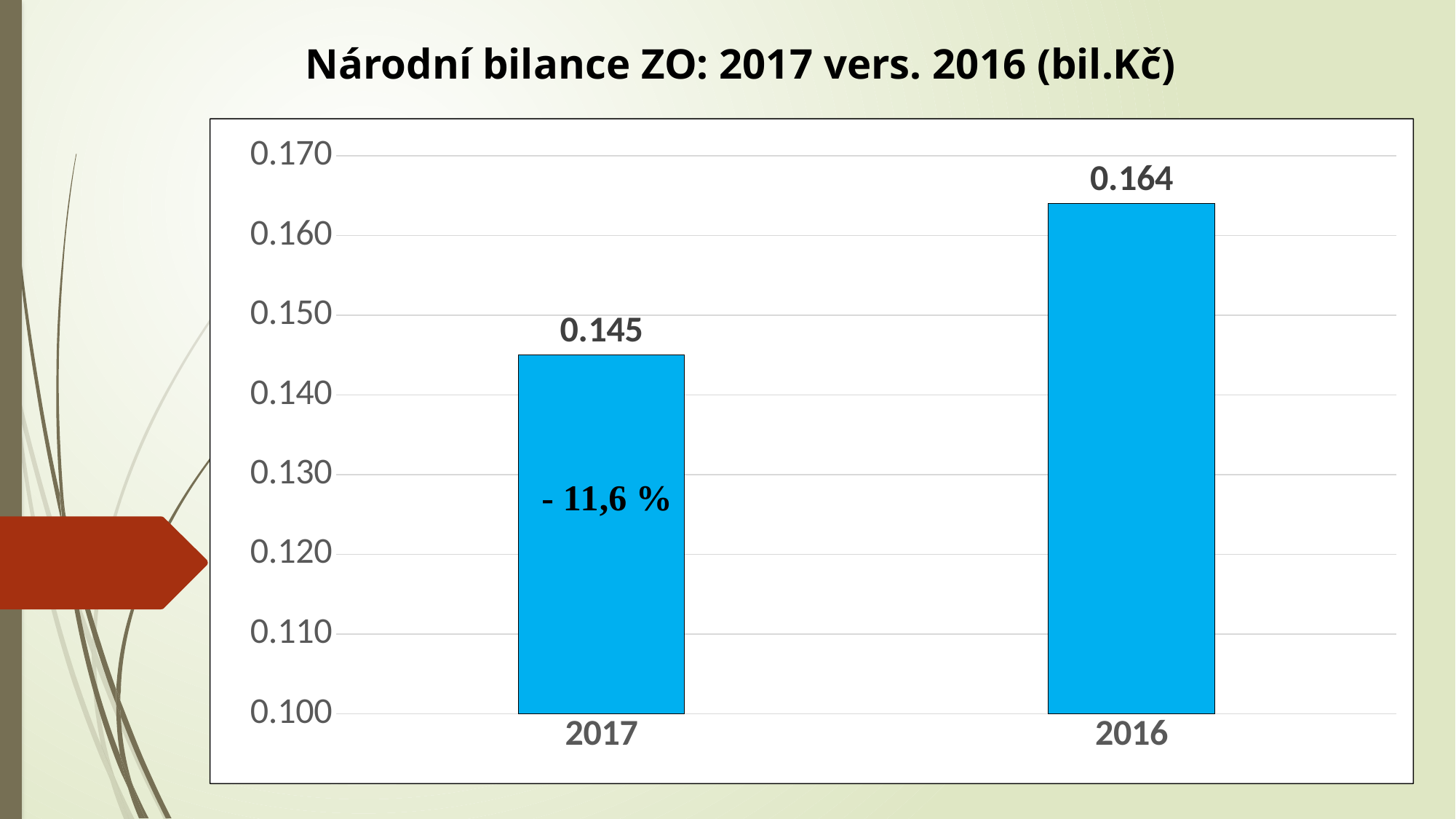
What percentage change is printed inside the 2017 bar? - 11,6 % What is the difference between the 2016 and 2017 values? 0.019 Is the value for 2017 greater or less than 0.150? less Is the value for 2016 greater or less than 0.160? greater What is the value for 2016? 0.164 Which year has the lower value? 2017 Which year has the higher value? 2016 What kind of chart is shown on the slide? bar chart How many bars are shown in the chart? 2 What is the title of the chart? Národní bilance ZO: 2017 vers. 2016 (bil.Kč) Is the value for 2017 larger or smaller than the value for 2016? smaller What is the value for 2017? 0.145